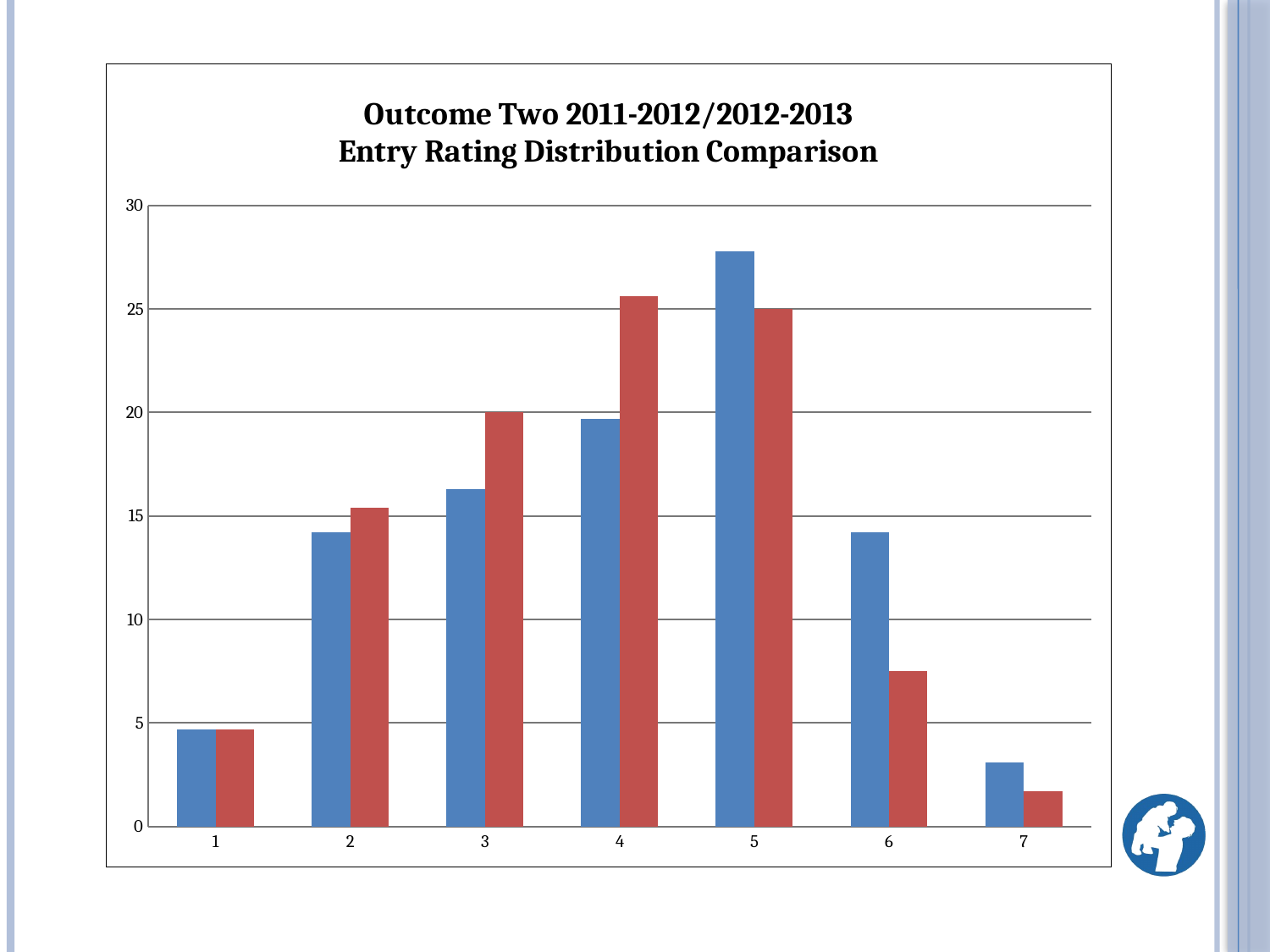
At category 6, which bar is larger, the blue one or the red one? blue For the blue bars, which category has the lowest value? 7 Is the value of the red bar for category 6 greater or less than 10? less For the blue bars, which category has the highest value? 5 How many categories are shown on the x axis? 7 What is the title of the chart? Outcome Two 2011-2012/2012-2013 Entry Rating Distribution Comparison What kind of chart is shown on the slide? bar chart For the red bars, which category has the highest value? 4 At category 3, which bar is larger, the blue one or the red one? red Is the value of the blue bar for category 5 greater or less than 25? greater Is the value of the blue bar for category 2 greater or less than 15? less For the red bars, which category has the lowest value? 7